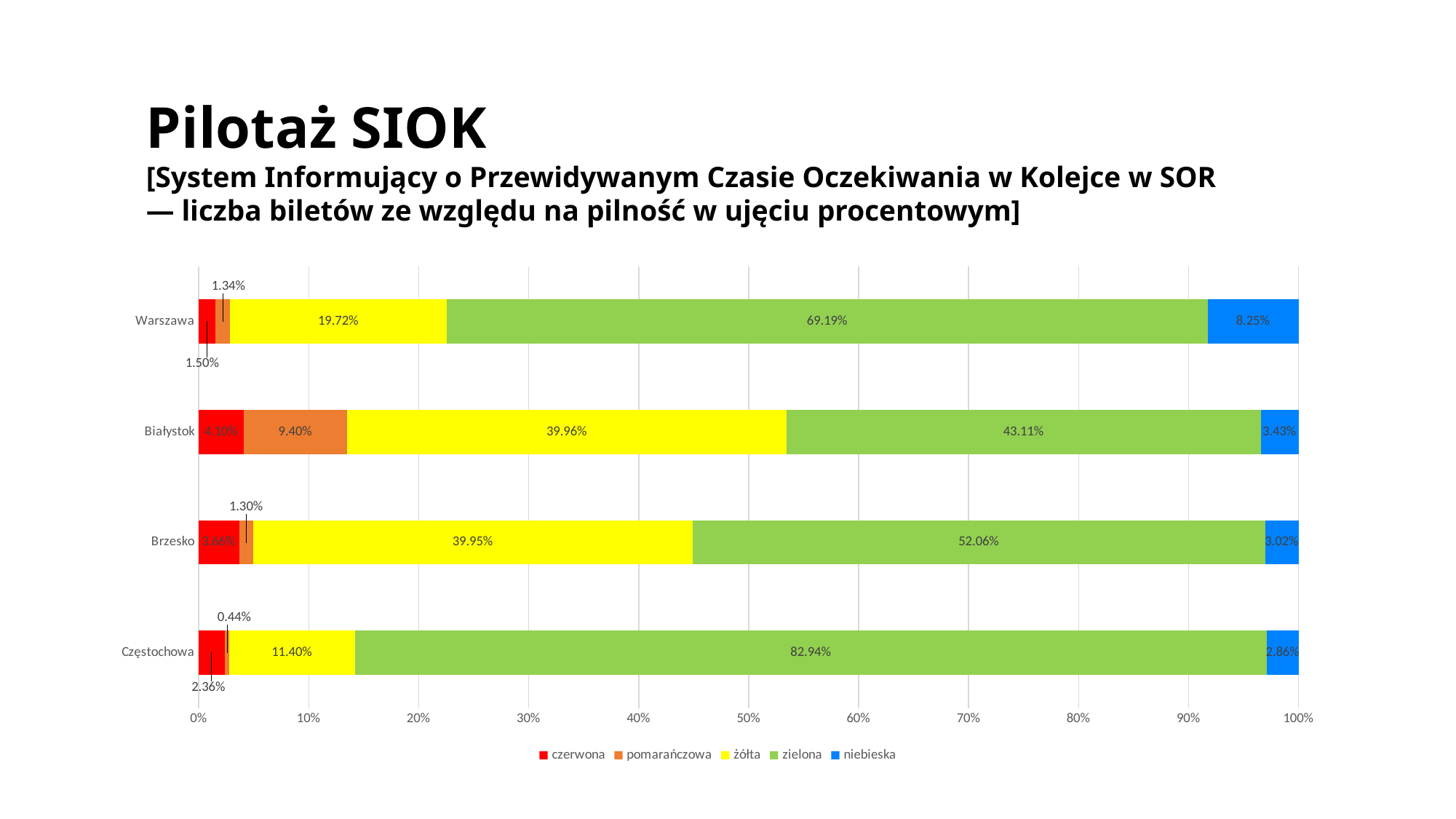
What is the value of the niebieska segment for Warszawa? 8.25% Which category has the highest zielona value? Częstochowa How many categories are shown on the chart? 4 Which has the larger pomarańczowa value, Białystok or Brzesko? Białystok What kind of chart is shown on the slide? Stacked bar chart What is the difference between the zielona values for Warszawa and Białystok? 26.08 percentage points Which category has the lowest żółta value? Częstochowa What is the value of the zielona segment for Częstochowa? 82.94% What colour represents the niebieska series in the legend? Blue How many series does the legend list? 5 What is the value of the żółta segment for Białystok? 39.96% What is the value of the pomarańczowa segment for Białystok? 9.40%